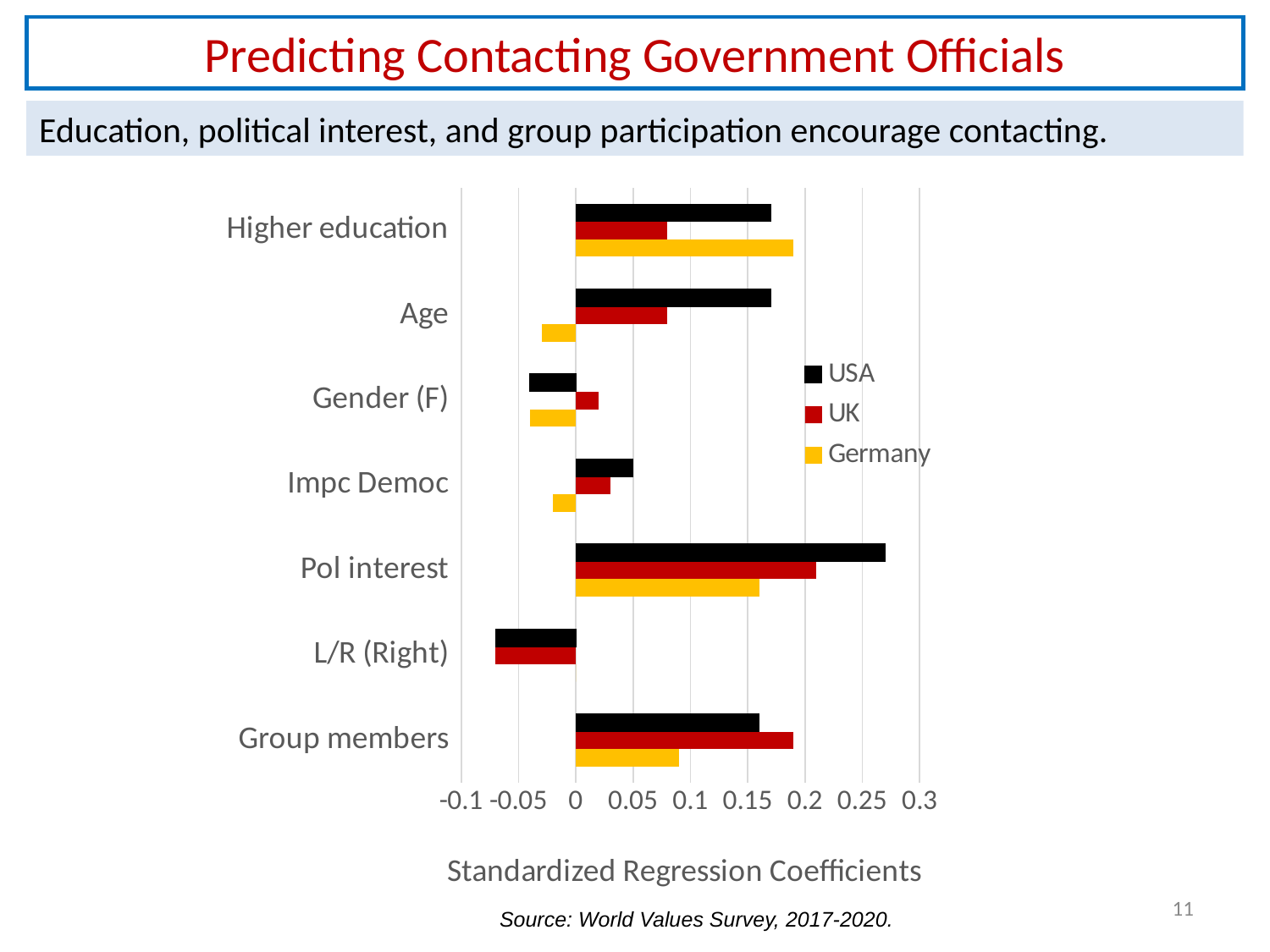
Is the Germany value for Higher education greater or less than 0.15? greater How many series does the chart's legend list? 3 For Group members, which series has the larger coefficient, UK or Germany? UK What is the label of the horizontal axis of the chart? Standardized Regression Coefficients How many predictor categories are listed on the vertical axis of the chart? 7 For which category does the USA series have its highest coefficient? Pol interest For which category does the USA series have its lowest coefficient? L/R (Right) For Age, which series has the larger coefficient, USA or Germany? USA Is the USA value for Pol interest greater or less than 0.25? greater Which countries are listed in the chart's legend? USA, UK, Germany Is the USA value for L/R (Right) greater or less than -0.05? less What kind of chart is shown on the slide? bar chart